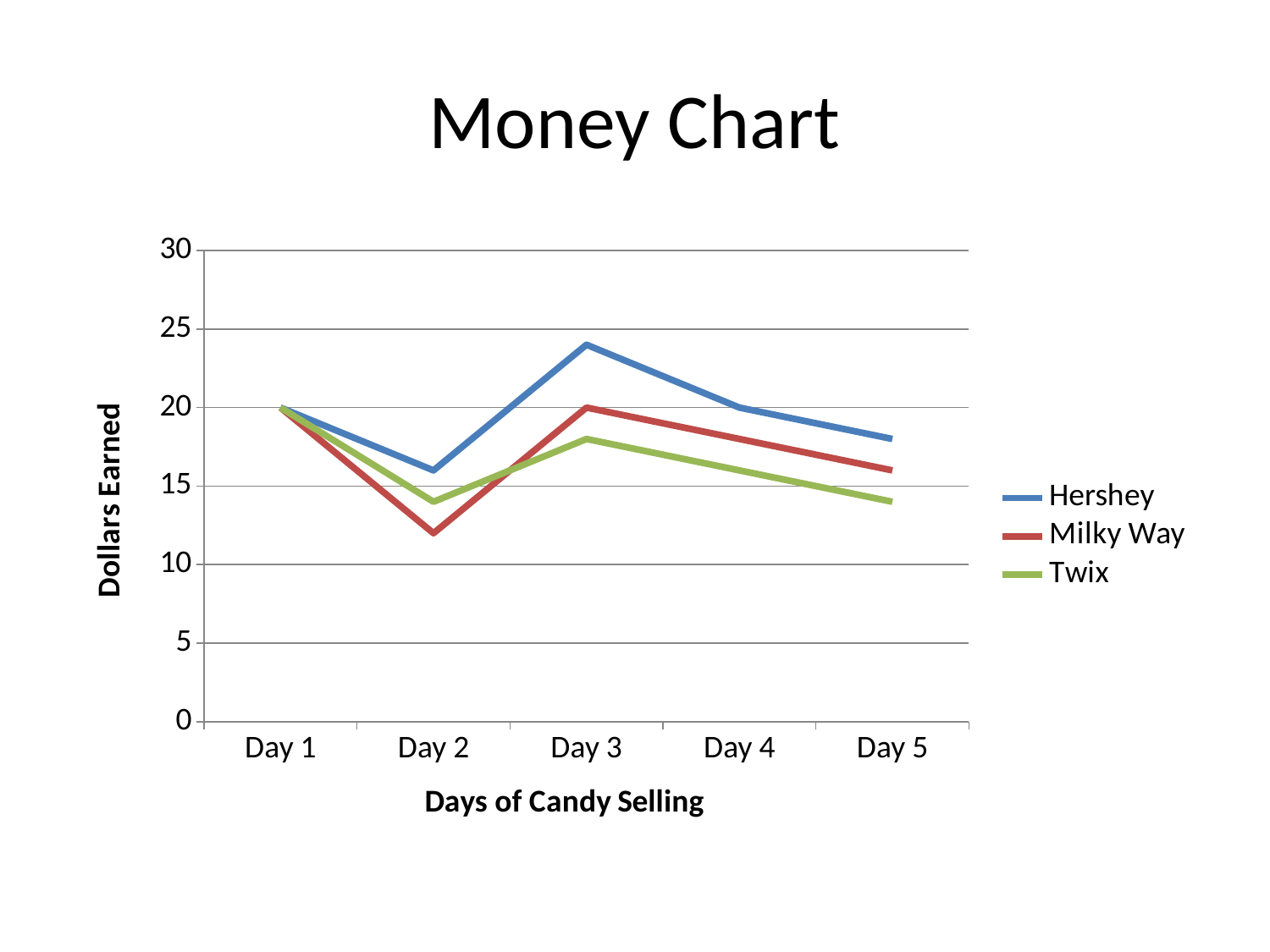
What is the value for Hershey on Day 1? 20 What is the value for Milky Way on Day 3? 20 What kind of chart is shown on the slide? line chart Is the value for Hershey on Day 3 greater or less than 20? greater What is the label of the y axis? Dollars Earned How many series does the legend list? 3 What is the value for Hershey on Day 4? 20 On Day 5, which is larger, the value for Hershey or the value for Twix? Hershey Is the value for Milky Way on Day 2 greater or less than 15? less Which series has the lowest value on Day 2? Milky Way Which series has the highest value on Day 3? Hershey How many days are plotted along the x axis? 5